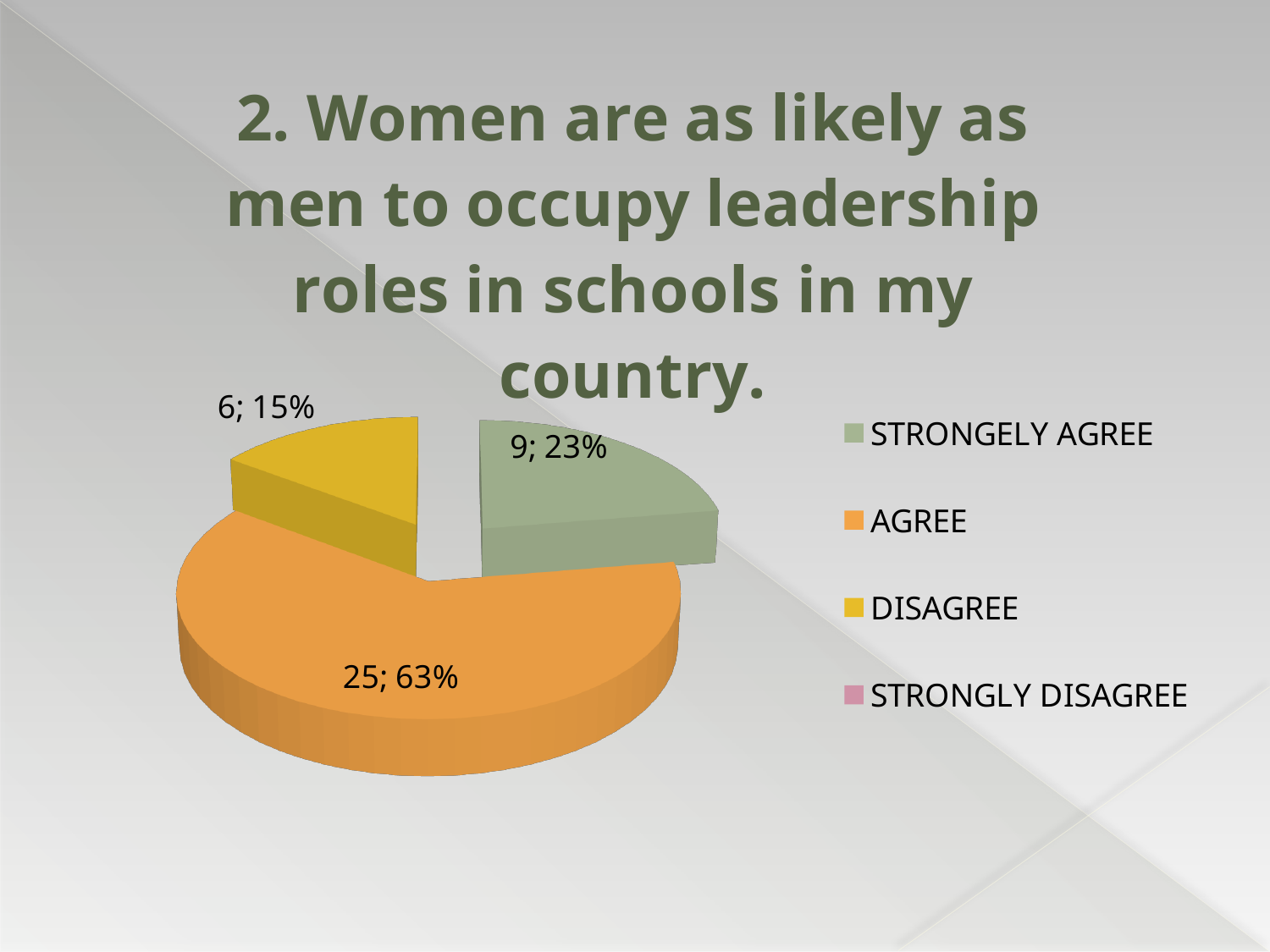
Which is larger, the STRONGLY AGREE slice or the DISAGREE slice? STRONGLY AGREE What is the difference between the AGREE count and the STRONGLY AGREE count? 16 What share of the pie does the AGREE slice represent? 63% Which response category has the largest slice of the pie? AGREE What is the count and percentage shown for the DISAGREE slice? 6; 15% What is the count and percentage shown for the STRONGLY AGREE slice? 9; 23% How many entries does the legend list? 4 What colour is the AGREE slice in the pie chart? orange Which legend entry has no visible slice in the pie? STRONGLY DISAGREE What kind of chart is shown on the slide? pie chart Which of the labelled slices is the smallest? DISAGREE What is the count and percentage shown for the AGREE slice? 25; 63%